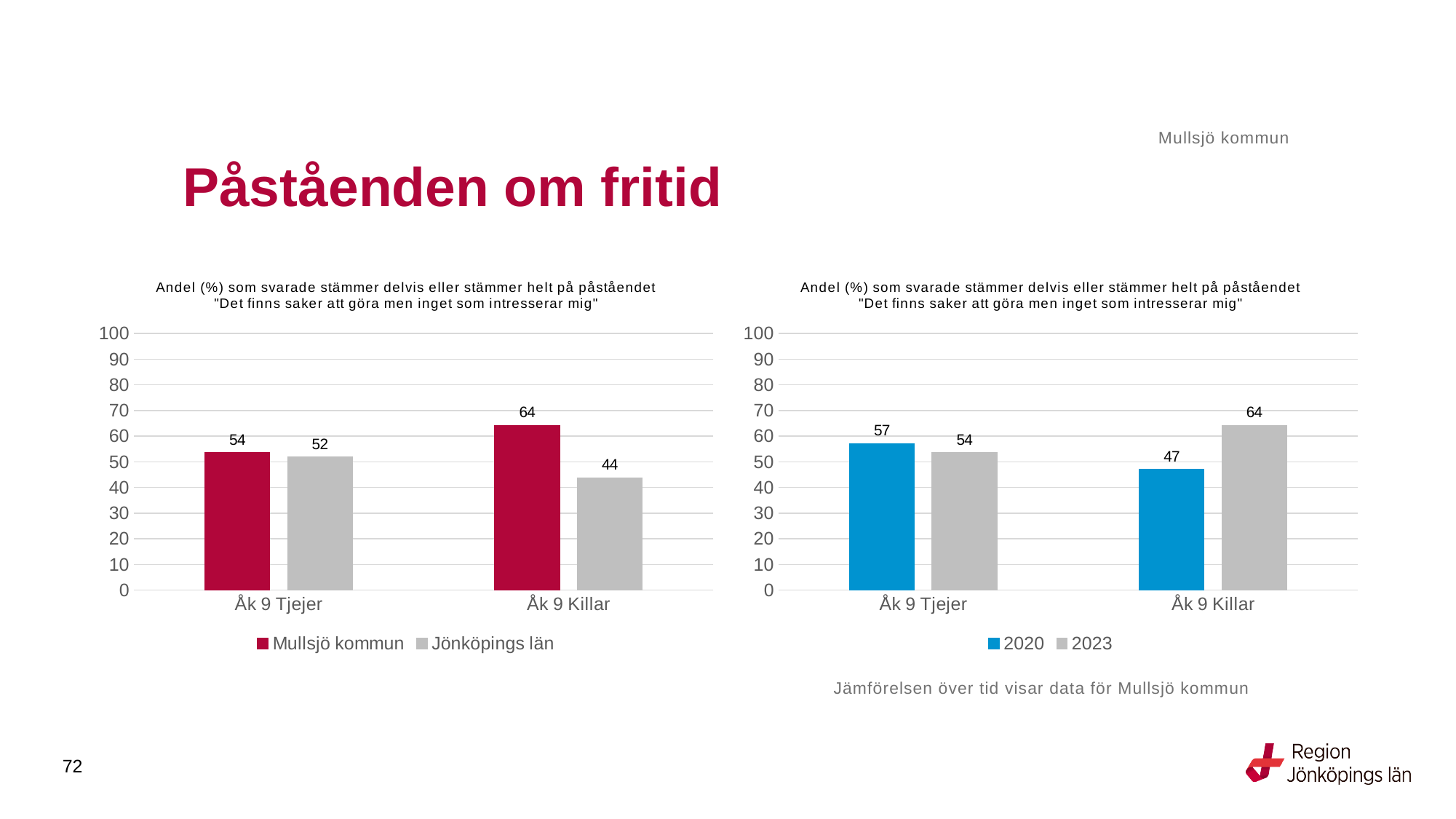
How many series does the legend of the left chart list? 2 In the left chart, what is the value for Jönköpings län for Åk 9 Tjejer? 52 In the right chart, which is larger for Åk 9 Tjejer: 2020 or 2023? 2020 In the left chart, which category has the lowest value for Jönköpings län? Åk 9 Killar In the left chart, what is the value for Mullsjö kommun for Åk 9 Killar? 64 In the right chart, which series is shown in blue? 2020 In the right chart, what is the value for 2020 for Åk 9 Tjejer? 57 What kind of chart is the right chart? bar chart In the right chart, is the value for 2020 for Åk 9 Killar greater or less than 50? less In the right chart, what is the value for 2023 for Åk 9 Killar? 64 In the left chart, what is the difference between Mullsjö kommun and Jönköpings län for Åk 9 Killar? 20 In the right chart, what is the difference between 2023 and 2020 for Åk 9 Killar? 17